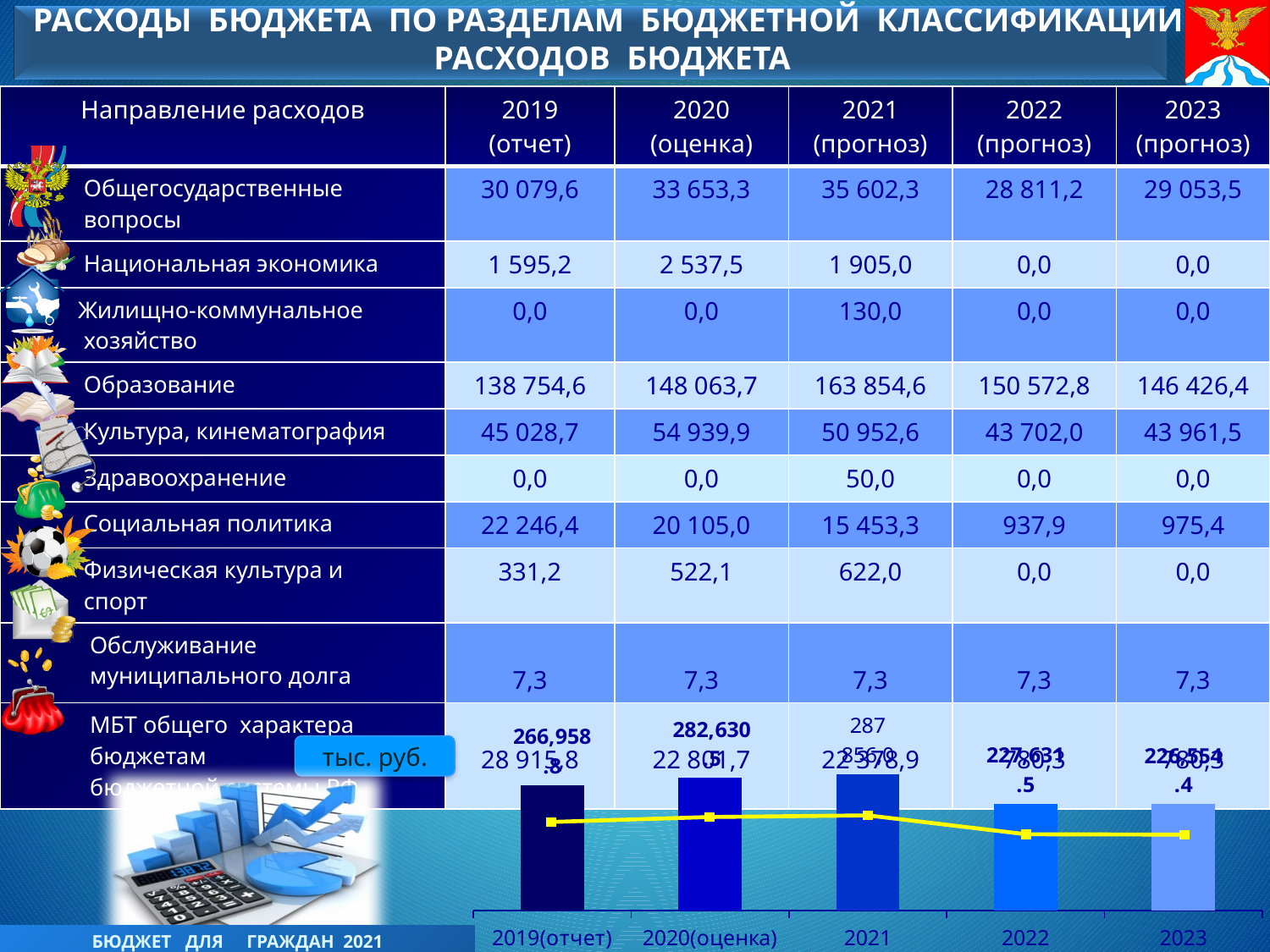
In the bar chart at the bottom of the slide, do the values rise or fall from 2019(отчет) to 2021? rise In the bar chart at the bottom of the slide, which bar is taller: 2019(отчет) or 2022? 2019(отчет) What colour is the line drawn across the bars in the chart at the bottom of the slide? yellow How many year categories are shown on the x axis of the bar chart at the bottom of the slide? 5 What kind of chart is shown at the bottom of the slide? bar chart What unit is shown in the label next to the chart at the bottom of the slide? тыс. руб. In the bar chart at the bottom of the slide, which bar is taller: 2021 or 2023? 2021 In the bar chart at the bottom of the slide, do the values rise or fall from 2021 to 2022? fall In the bar chart at the bottom of the slide, which bar is taller: 2020(оценка) or 2023? 2020(оценка) In the bar chart at the bottom of the slide, what is the value labelled for 2019(отчет)? 266,958.8 In the bar chart at the bottom of the slide, what is the value labelled for 2022? 227,631.5